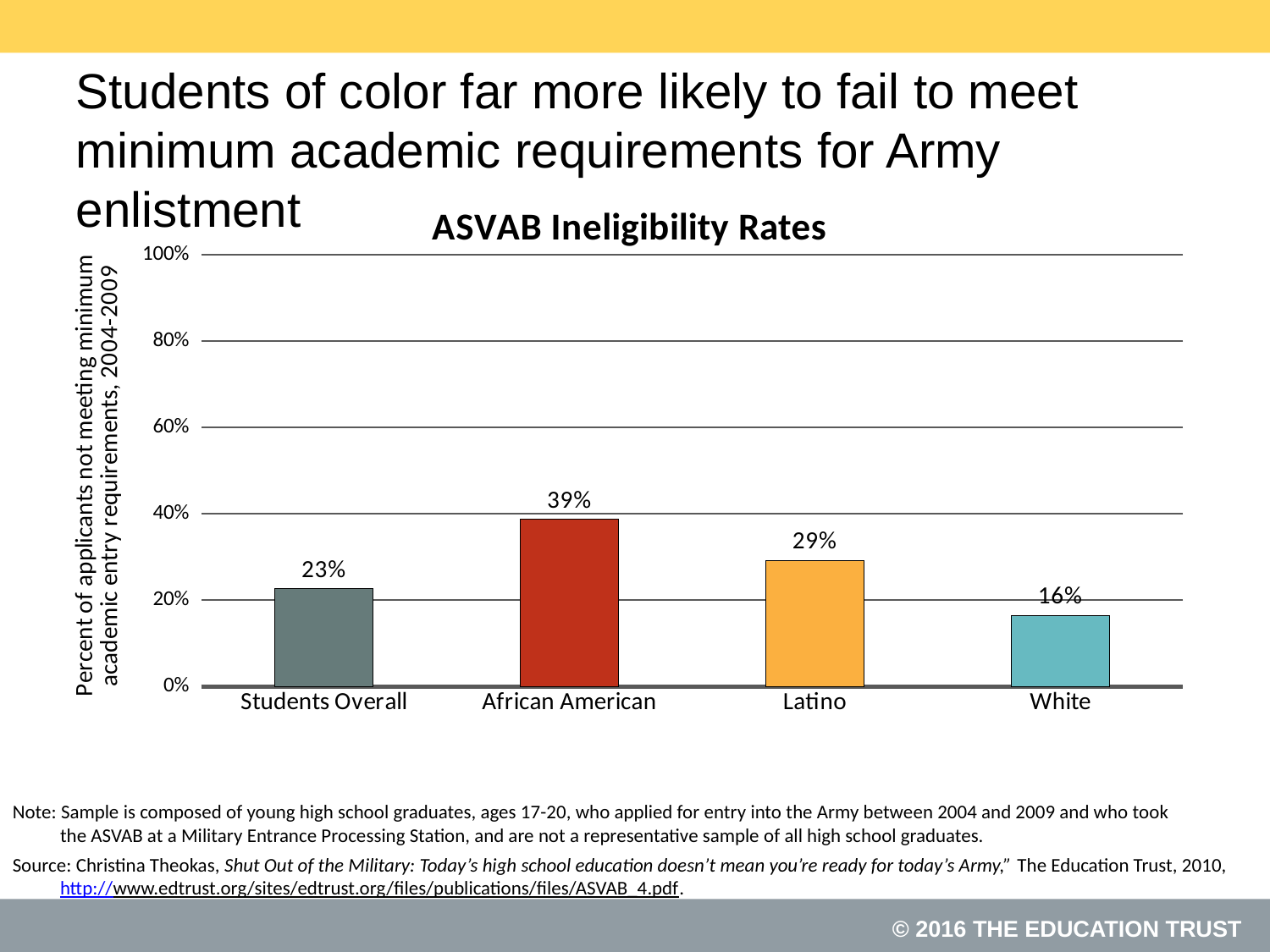
Which group has the lowest ASVAB ineligibility rate? White What is the ASVAB ineligibility rate for Latino students? 29% Which group has the highest ASVAB ineligibility rate? African American What is the difference between the ineligibility rates for African American and White students? 23 percentage points Is the value for Latino greater or less than 20%? greater How many groups are shown in the chart? 4 What kind of chart is shown on the slide? Bar chart What is the ASVAB ineligibility rate for Students Overall? 23% Which group has a higher ineligibility rate, Latino or Students Overall? Latino What is the ASVAB ineligibility rate for African American students? 39% What is the ASVAB ineligibility rate for White students? 16% What is the title of the chart? ASVAB Ineligibility Rates